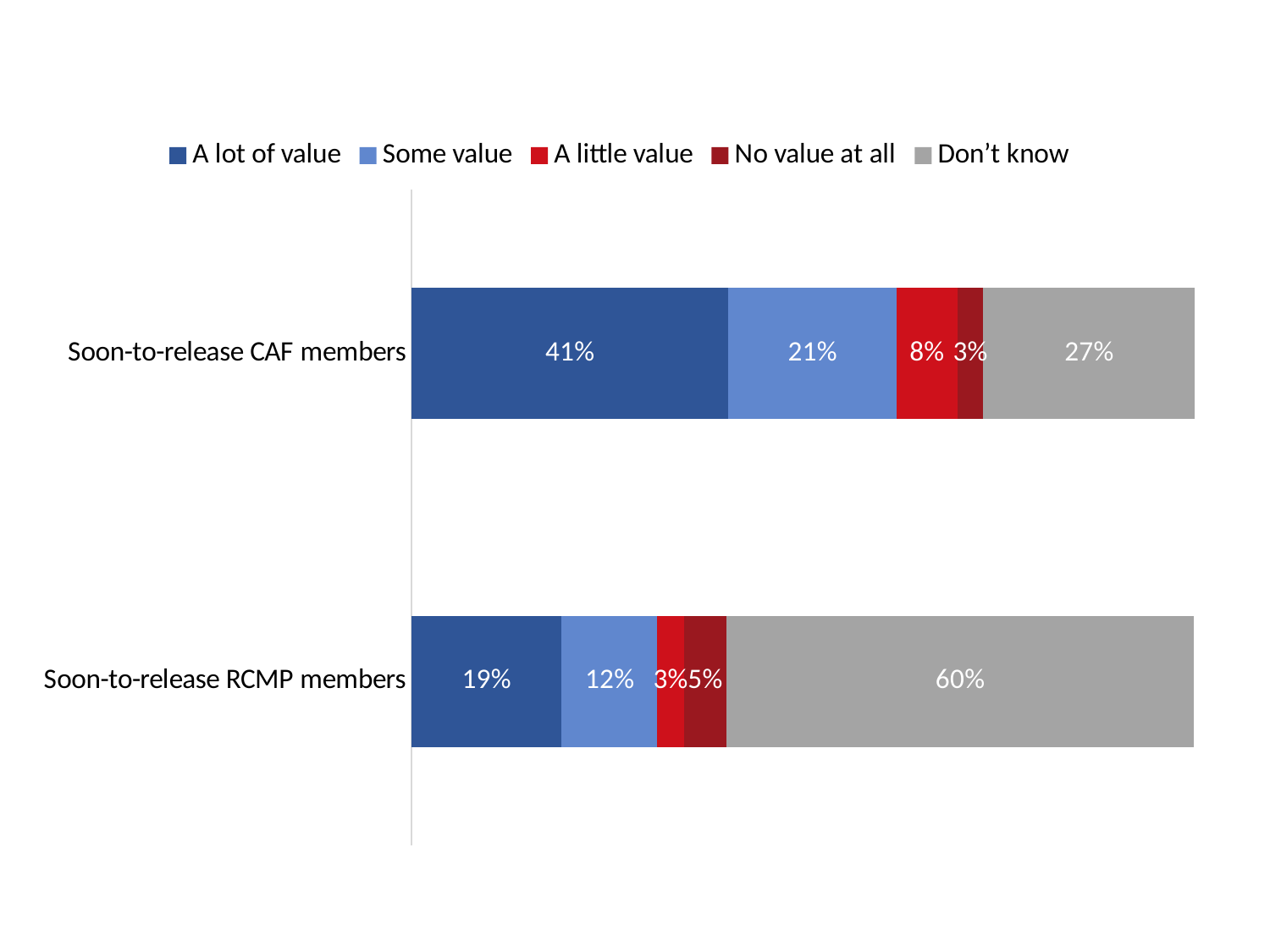
Which response category is the smallest for soon-to-release RCMP members? A little value Which group has the larger "Don't know" share? Soon-to-release RCMP members What is the difference between the "A lot of value" percentages for CAF members and RCMP members? 22 percentage points What is the difference between the "Don't know" percentages for RCMP members and CAF members? 33 percentage points How many series does the legend list? 5 How many groups (categories) are shown on the chart? 2 What percentage of soon-to-release RCMP members answered "Don't know"? 60% What percentage of soon-to-release CAF members said "No value at all"? 3% What percentage of soon-to-release CAF members said "A lot of value"? 41% What type of chart is shown? Stacked bar chart Which response category is the largest for soon-to-release CAF members? A lot of value What percentage of soon-to-release RCMP members said "Some value"? 12%